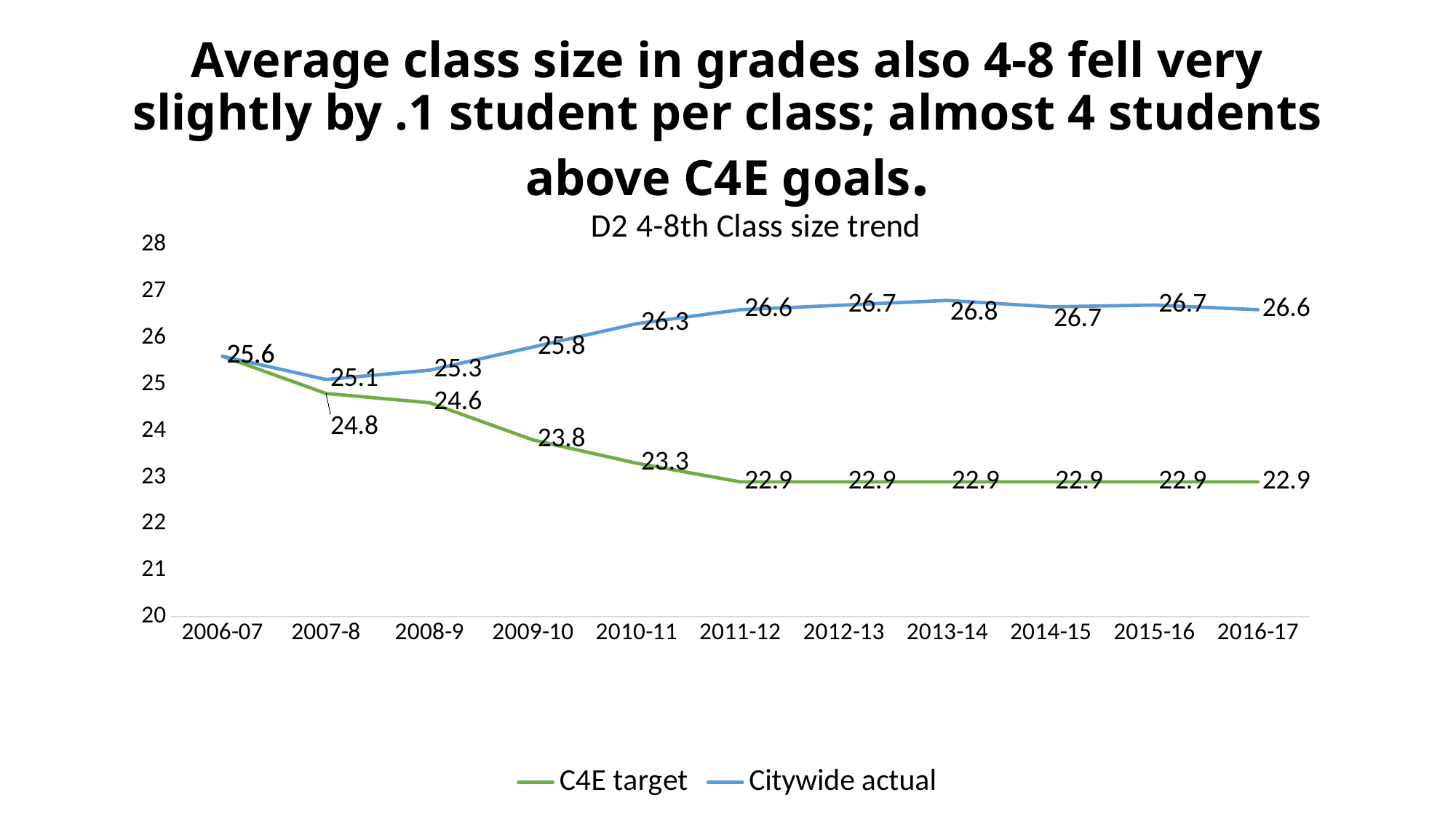
What is the Citywide actual value for 2013-14? 26.8 What is the lowest C4E target value shown? 22.9 How many school years are shown on the x axis? 11 What is the title of the chart? D2 4-8th Class size trend In which school year is the Citywide actual value highest? 2013-14 Does the C4E target line rise or fall from 2006-07 to 2011-12? fall Which series has the larger value in 2010-11, C4E target or Citywide actual? Citywide actual What is the Citywide actual value for 2016-17? 26.6 How many series does the legend list? 2 What is the C4E target value for 2009-10? 23.8 What is the difference between the Citywide actual and the C4E target in 2016-17? 3.7 What kind of chart is shown on the slide? line chart